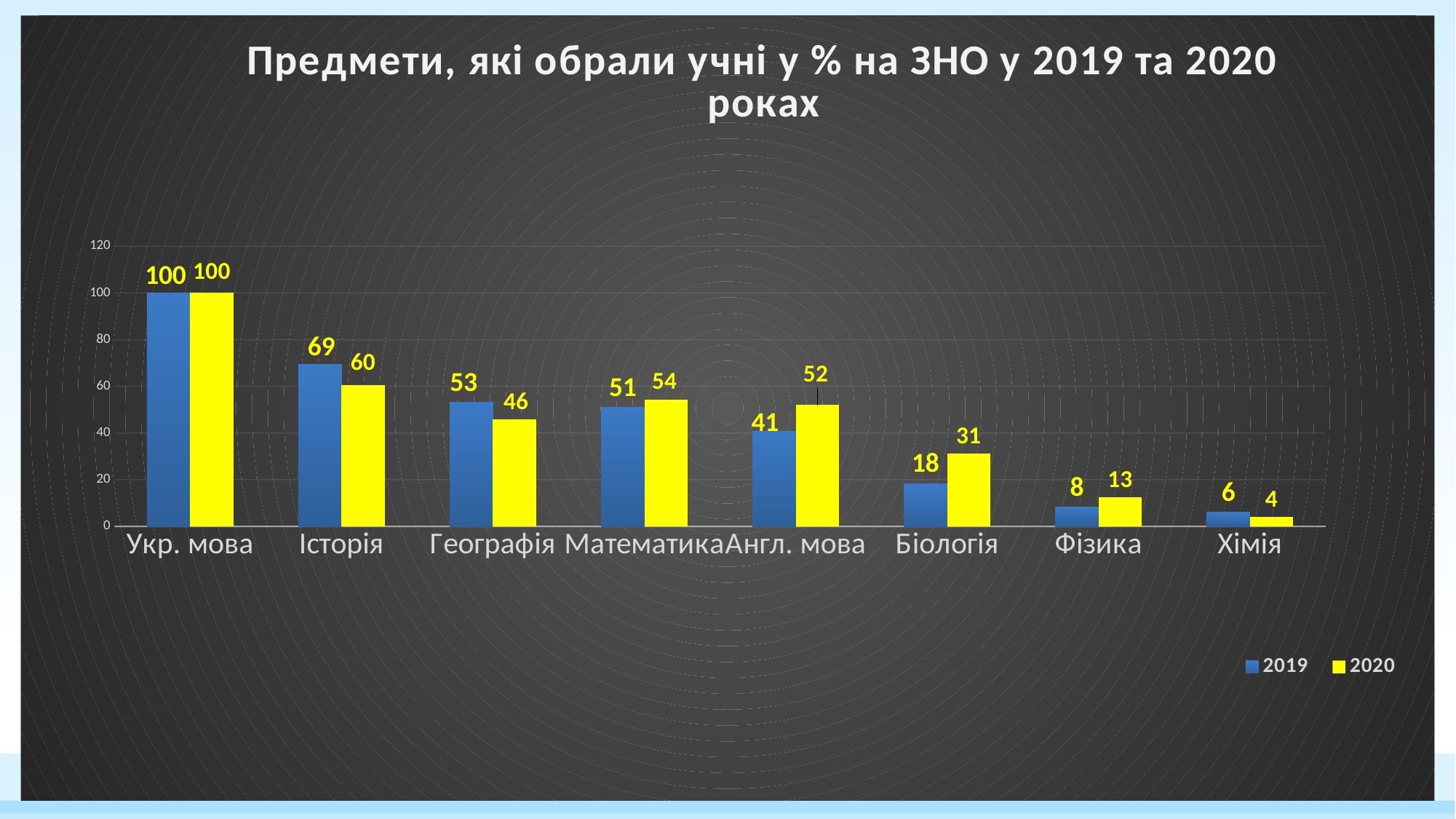
How many series does the legend list? 2 What kind of chart is shown on the slide? Bar chart How many categories are shown on the x axis? 8 Which category has the highest value in the 2019 series? Укр. мова What is the value for Історія in the 2019 series? 69 What is the difference between the 2020 values for Біологія and Фізика? 18 Which colour represents the 2020 series? Yellow What is the value for Англ. мова in the 2019 series? 41 What is the difference between the 2019 and 2020 values for Історія? 9 Which is larger for Математика: the 2019 value or the 2020 value? 2020 Which category has the lowest value in the 2020 series? Хімія What is the value for Біологія in the 2020 series? 31